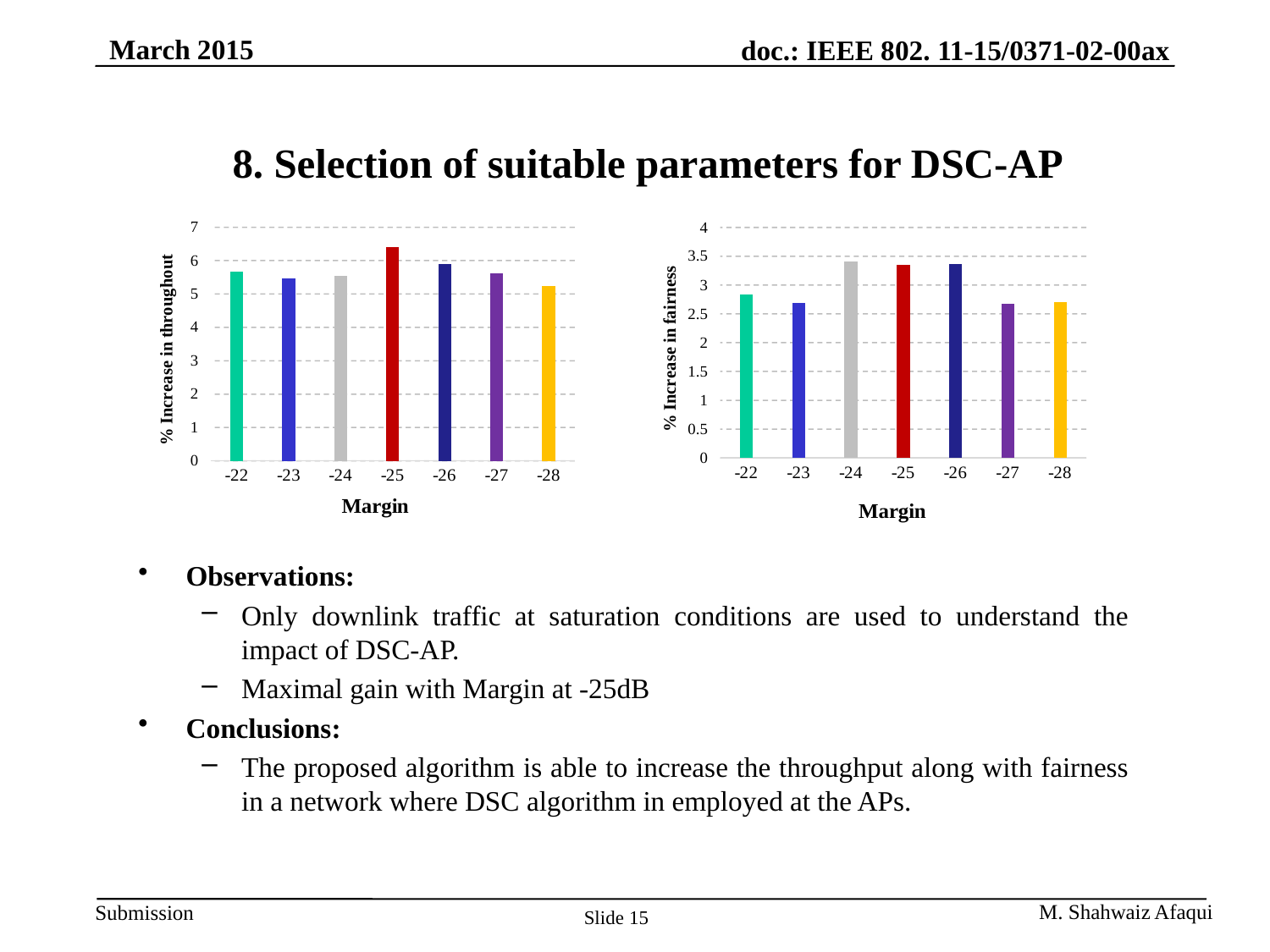
How many Margin values are plotted on the left chart (% Increase in throughput)? 7 How many Margin values are plotted on the right chart (% Increase in fairness)? 7 What is the y-axis title of the right chart? % Increase in fairness On the right chart (% Increase in fairness), is the value for Margin -27 greater or less than 3? less On the left chart (% Increase in throughput), is the value for Margin -28 greater or less than 6? less What kind of chart is the left chart showing % Increase in throughput? bar chart On the left chart (% Increase in throughput), is the value for Margin -25 greater or less than 6? greater On the left chart (% Increase in throughput), which Margin has the lowest value? -28 On the left chart (% Increase in throughput), which Margin has the highest value? -25 On the left chart (% Increase in throughput), which is larger, the value for Margin -25 or Margin -23? -25 On the right chart (% Increase in fairness), which is larger, the value for Margin -24 or Margin -22? -24